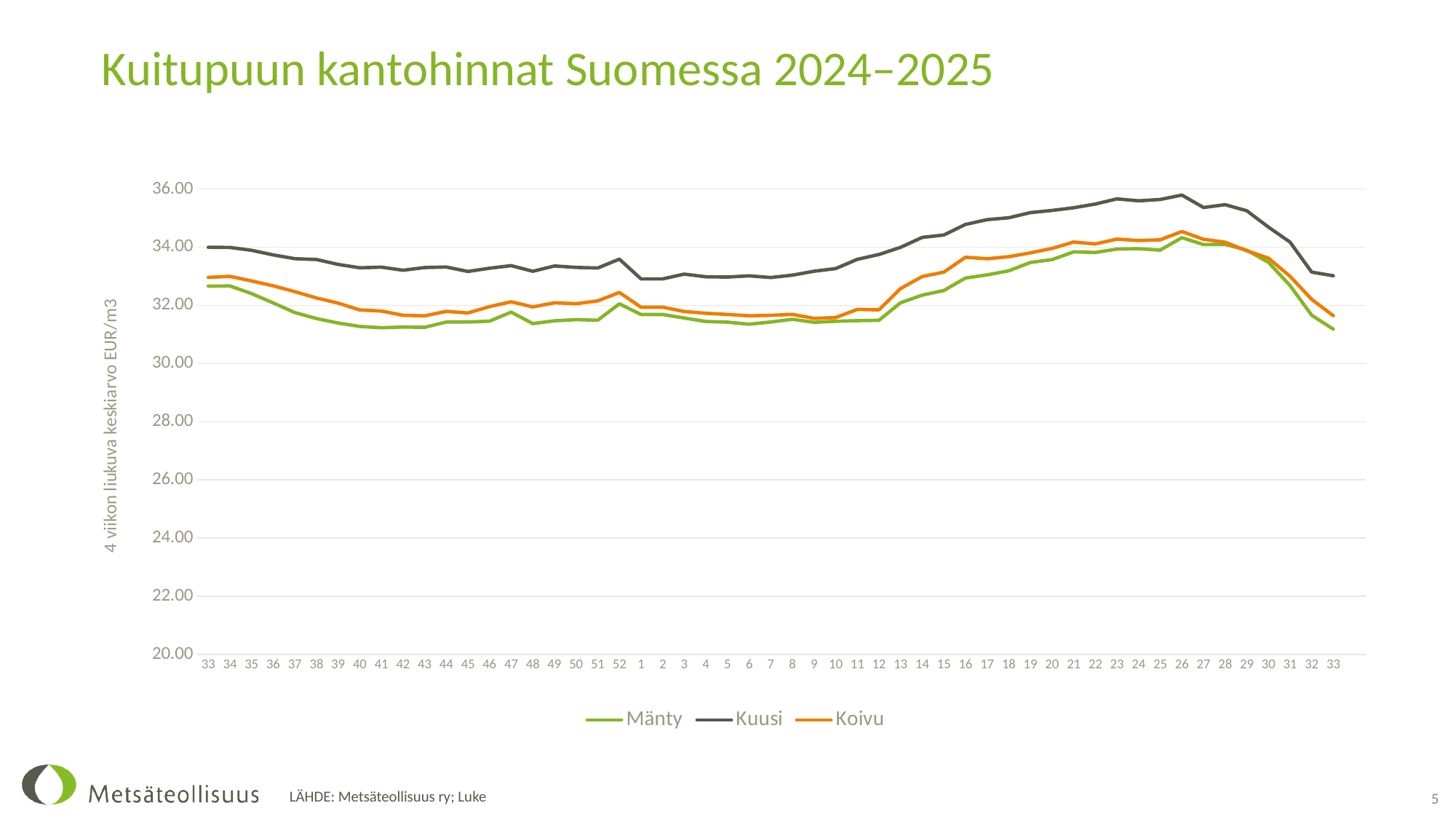
Do the Kuusi values rise or fall from week 12 to week 26? rise Is the value for Mänty at week 40 greater or less than 32.00? less Is the value for Koivu at week 16 greater or less than 32.00? greater Which series has the higher value at week 26, Kuusi or Mänty? Kuusi Which series has the highest values across the whole chart? Kuusi What is the label on the vertical axis? 4 viikon liukuva keskiarvo EUR/m3 How many series does the legend list? 3 Is the value for Kuusi at week 26 greater or less than 34.00? greater What is the title of the chart? Kuitupuun kantohinnat Suomessa 2024–2025 Which series has the higher value at week 40, Koivu or Mänty? Koivu What kind of chart is shown on the slide? line chart